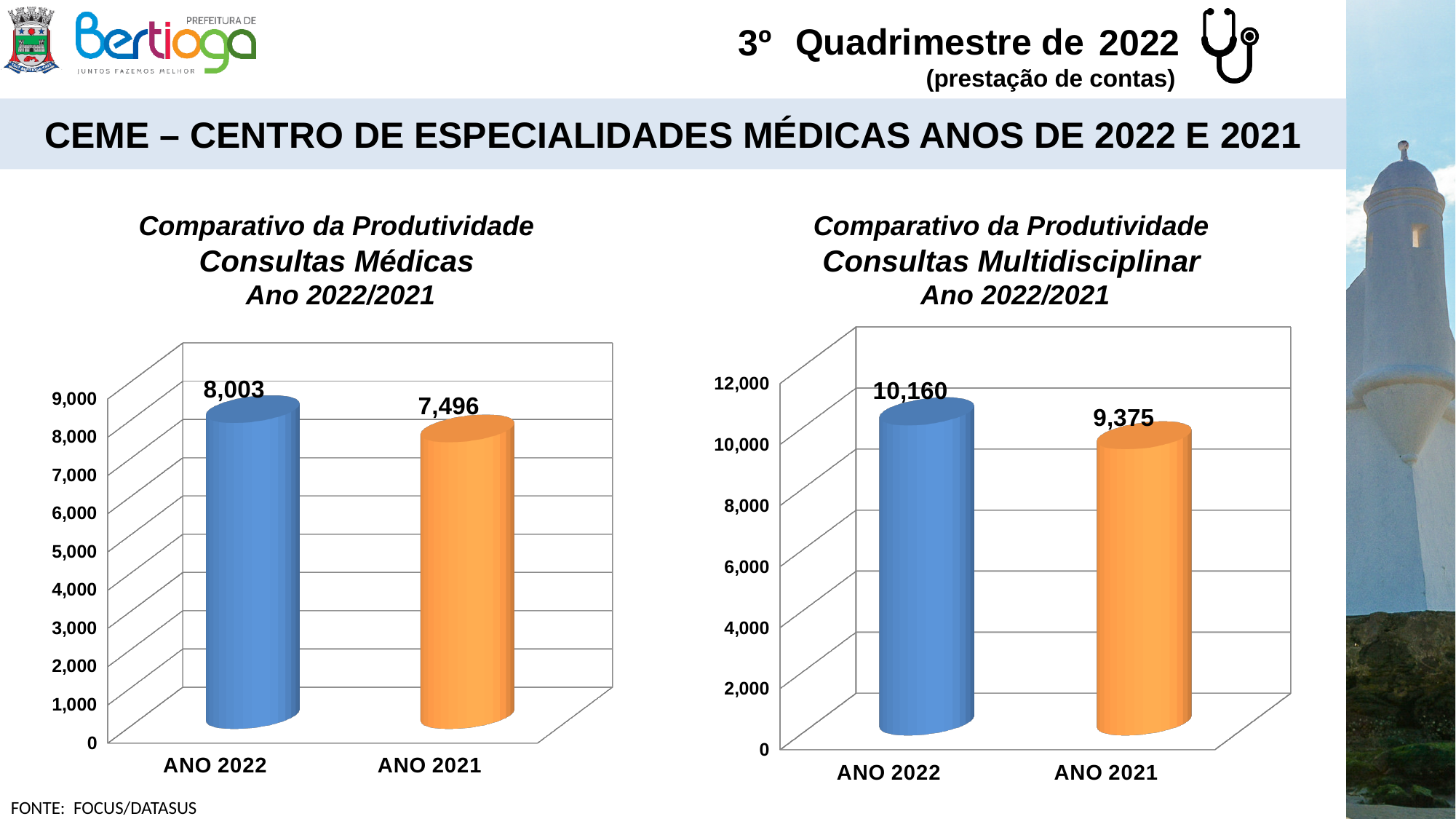
In the 'Consultas Multidisciplinar' chart on the right, is the value for ANO 2022 greater or less than 10,000? greater What kind of chart is the 'Consultas Multidisciplinar' chart on the right? bar chart In the 'Consultas Médicas' chart on the left, what is the value for ANO 2021? 7,496 In the 'Consultas Médicas' chart on the left, which year has the higher value? ANO 2022 How many bars are plotted in the 'Consultas Médicas' chart on the left? 2 In the 'Consultas Multidisciplinar' chart on the right, which year has the lower value? ANO 2021 In the 'Consultas Multidisciplinar' chart on the right, what is the value for ANO 2022? 10,160 In the 'Consultas Médicas' chart on the left, what is the value for ANO 2022? 8,003 In the 'Consultas Médicas' chart on the left, what colour is the bar for ANO 2021? orange In the 'Consultas Multidisciplinar' chart on the right, what is the difference between the ANO 2022 and ANO 2021 values? 785 In the 'Consultas Médicas' chart on the left, what is the difference between the ANO 2022 and ANO 2021 values? 507 In the 'Consultas Multidisciplinar' chart on the right, what is the value for ANO 2021? 9,375